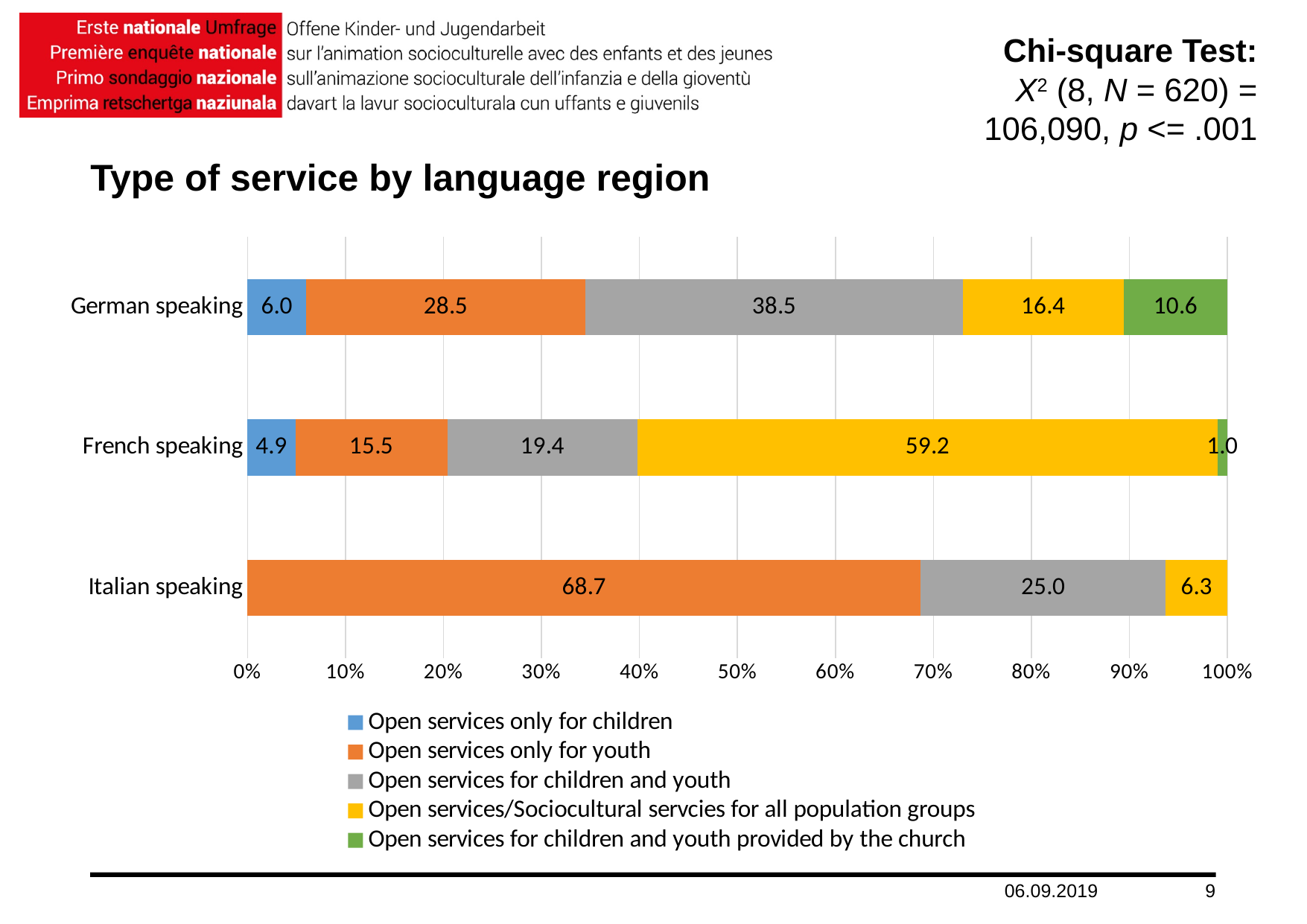
Which language region has the highest value for 'Open services only for youth'? Italian speaking What is the title of the chart? Type of service by language region Which language region has the lowest value for 'Open services for children and youth'? French speaking What is the value for 'Open services for children and youth provided by the church' in the German speaking region? 10.6 How many series does the legend list? 5 What is the difference between the 'Open services only for youth' values for the German speaking and French speaking regions? 13.0 What is the value for 'Open services for children and youth' in the German speaking region? 38.5 Which is larger: 'Open services only for children' in the German speaking region or in the French speaking region? German speaking What is the value for 'Open services only for youth' in the Italian speaking region? 68.7 How many language regions are shown on the chart? 3 What is the value for 'Open services/Sociocultural servcies for all population groups' in the French speaking region? 59.2 What kind of chart is shown on the slide? Stacked bar chart